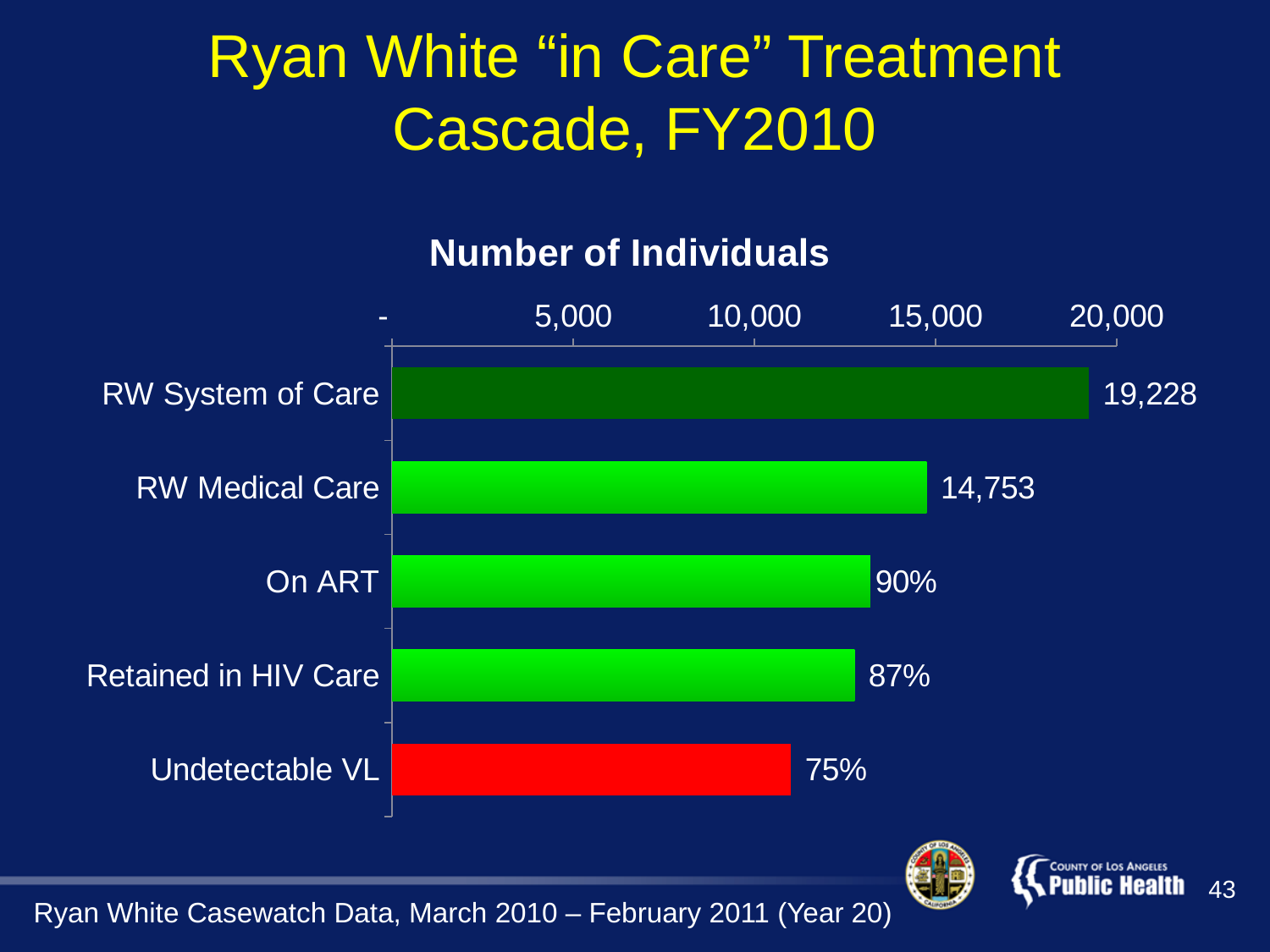
What is the value shown for Undetectable VL? 75% What is the difference between the values for RW System of Care and RW Medical Care? 4,475 What is the value shown for On ART? 90% Which category has the shortest bar? Undetectable VL What kind of chart is shown on the slide? Bar chart What is the value shown for RW Medical Care? 14,753 What is the value shown for Retained in HIV Care? 87% Is the bar for RW Medical Care greater or less than 10,000 on the axis? greater What is the value shown for RW System of Care? 19,228 How many categories are shown in the chart? 5 Which is larger, the value for On ART or the value for Retained in HIV Care? On ART Which category has the longest bar? RW System of Care